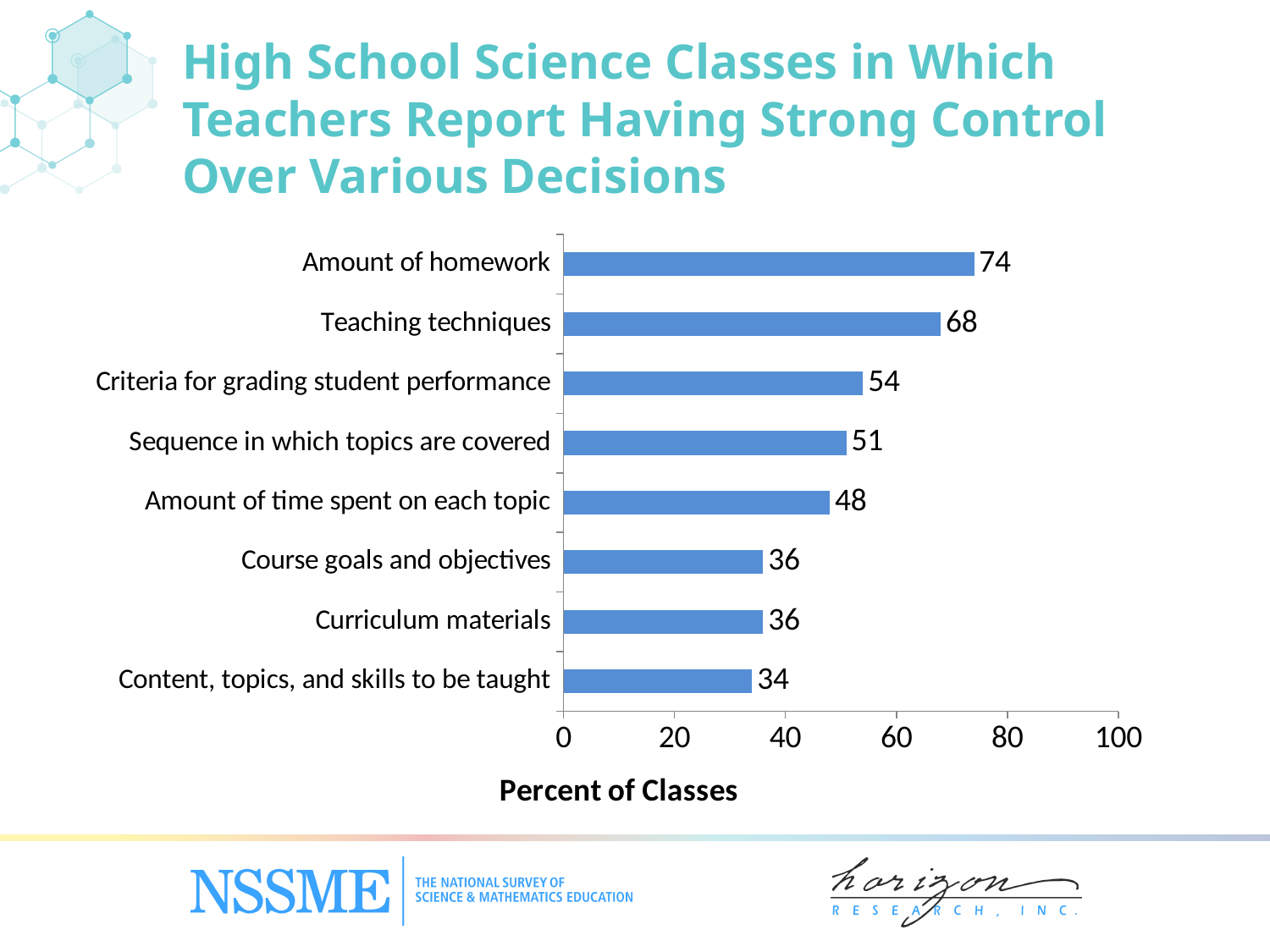
Which is larger, the value for Teaching techniques or the value for Criteria for grading student performance? Teaching techniques What is the difference between the values for Amount of homework and Teaching techniques? 6 Which decision has the highest percent of classes? Amount of homework What percent of classes is shown for Amount of homework? 74 What kind of chart is shown on the slide? Bar chart What is the value for Content, topics, and skills to be taught? 34 What is the value for Sequence in which topics are covered? 51 Which decision has the lowest percent of classes? Content, topics, and skills to be taught What is the label of the horizontal axis? Percent of Classes How many decision categories are shown in the chart? 8 Is the value for Amount of time spent on each topic greater or less than 40? greater What is the difference between the values for Criteria for grading student performance and Amount of time spent on each topic? 6